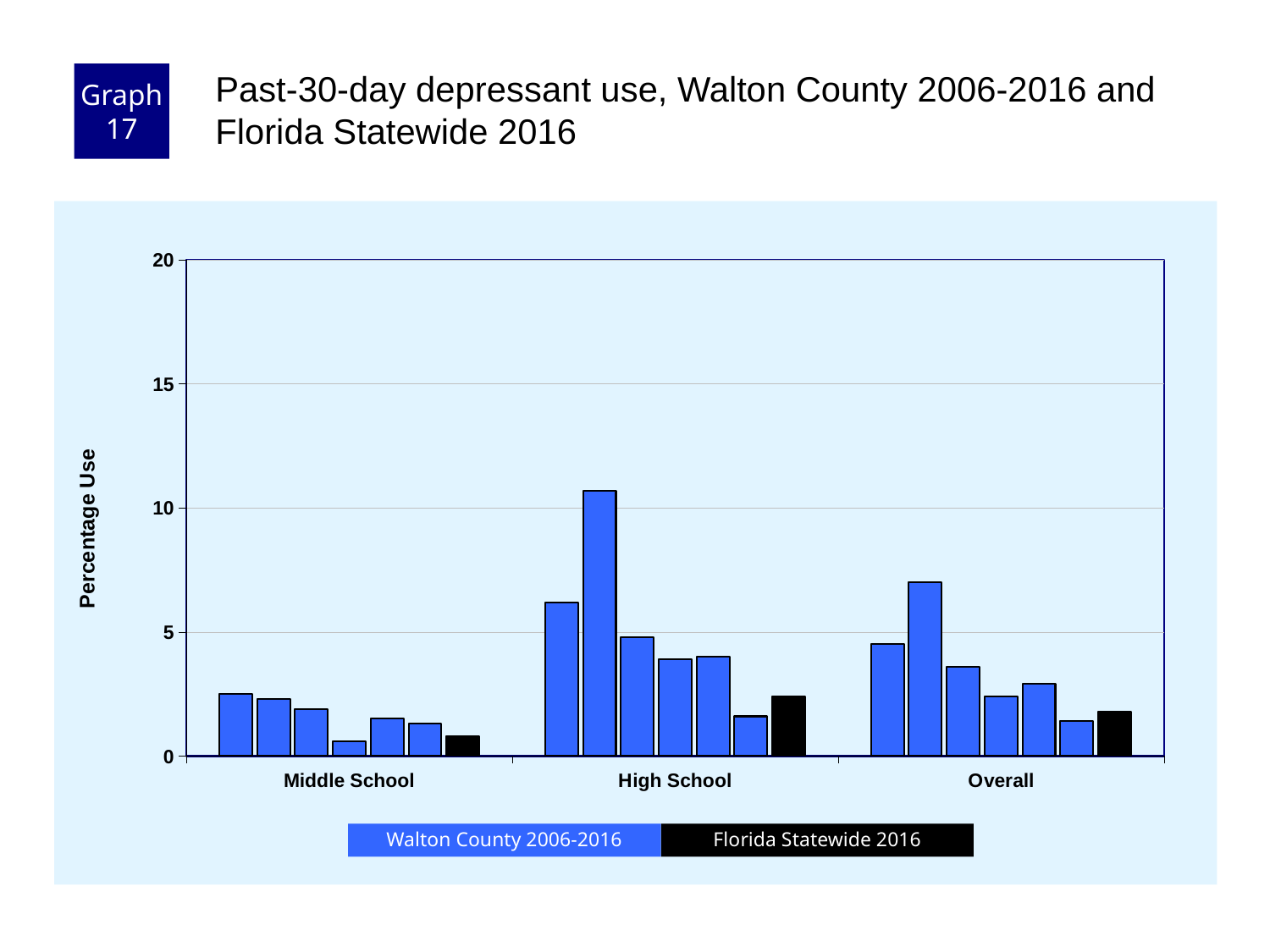
Is the tallest Walton County 2006-2016 bar in the Overall category greater or less than 5? greater Which is larger, the Florida Statewide 2016 value for High School or for Middle School? High School Is the tallest Walton County 2006-2016 bar in the High School category greater or less than 10? greater What colour represents Florida Statewide 2016 in the chart? black Is the tallest Walton County 2006-2016 bar in the Middle School category greater or less than 5? less How many series does the chart's legend list? 2 What is the label on the y axis of the chart? Percentage Use What kind of chart is shown on the slide? bar chart How many categories are shown on the x axis of the chart? 3 Which category contains the lowest bars overall in the chart? Middle School Which category contains the tallest bar in the chart? High School